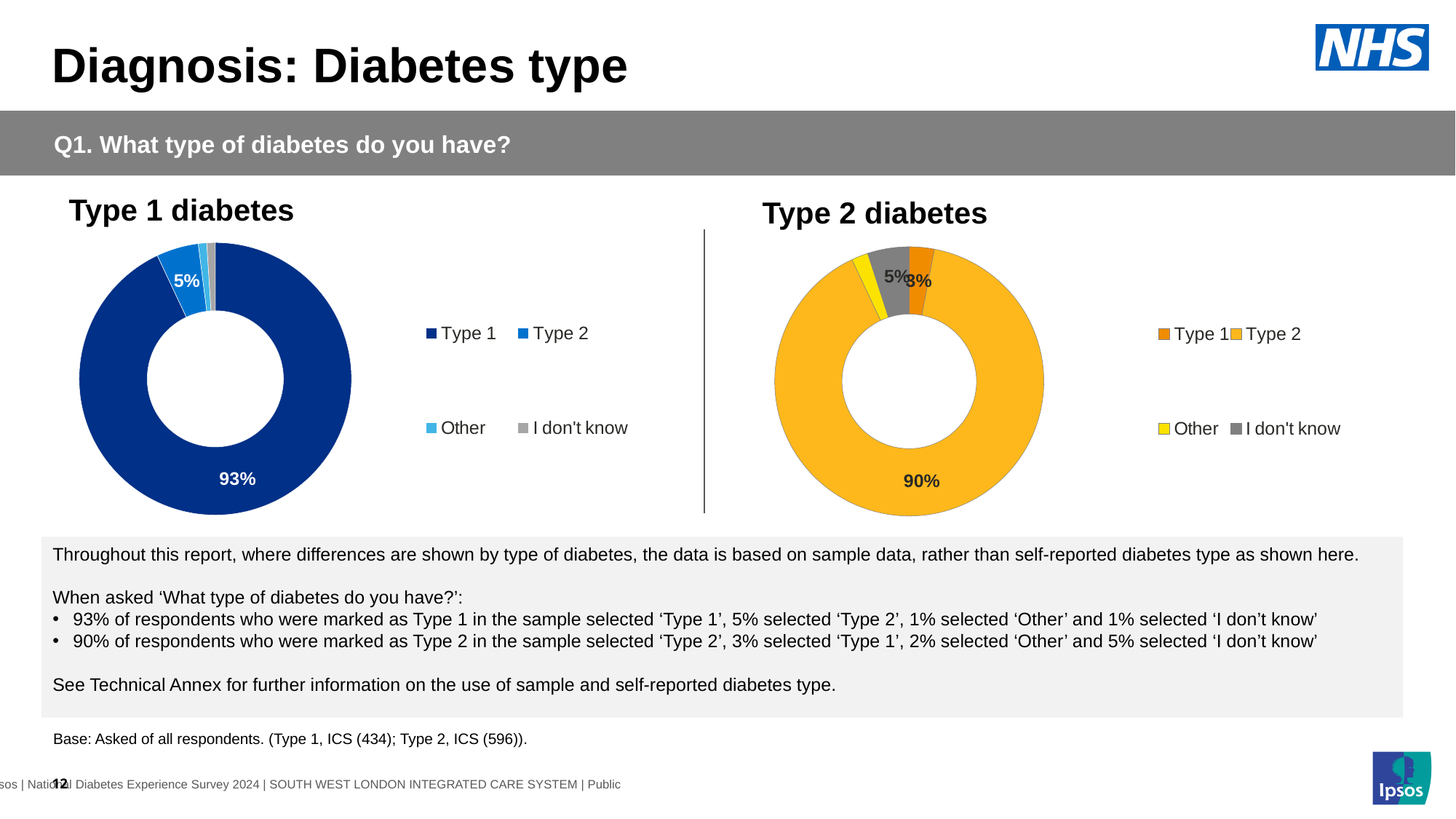
What kind of chart is used on this slide? Donut (pie) chart In the 'Type 2 diabetes' chart, what percentage of respondents selected 'I don't know'? 5% In the 'Type 2 diabetes' chart, what percentage of respondents selected 'Type 2'? 90% What is the title of the chart on the left of the slide? Type 1 diabetes In the 'Type 1 diabetes' chart, what is the difference between the 'Type 1' share and the 'Type 2' share? 88 percentage points In the 'Type 1 diabetes' chart, which category has the largest share? Type 1 In the 'Type 1 diabetes' chart, what percentage of respondents selected 'Type 2'? 5% In the 'Type 2 diabetes' chart, which category is shown in grey? I don't know In the 'Type 1 diabetes' chart, what percentage of respondents selected 'Type 1'? 93% Which is larger: the 'Type 1' share in the 'Type 1 diabetes' chart or the 'Type 2' share in the 'Type 2 diabetes' chart? The 'Type 1' share in the 'Type 1 diabetes' chart (93%) In the 'Type 2 diabetes' chart, which category has the largest share? Type 2 How many categories does the legend of the 'Type 2 diabetes' chart list? 4